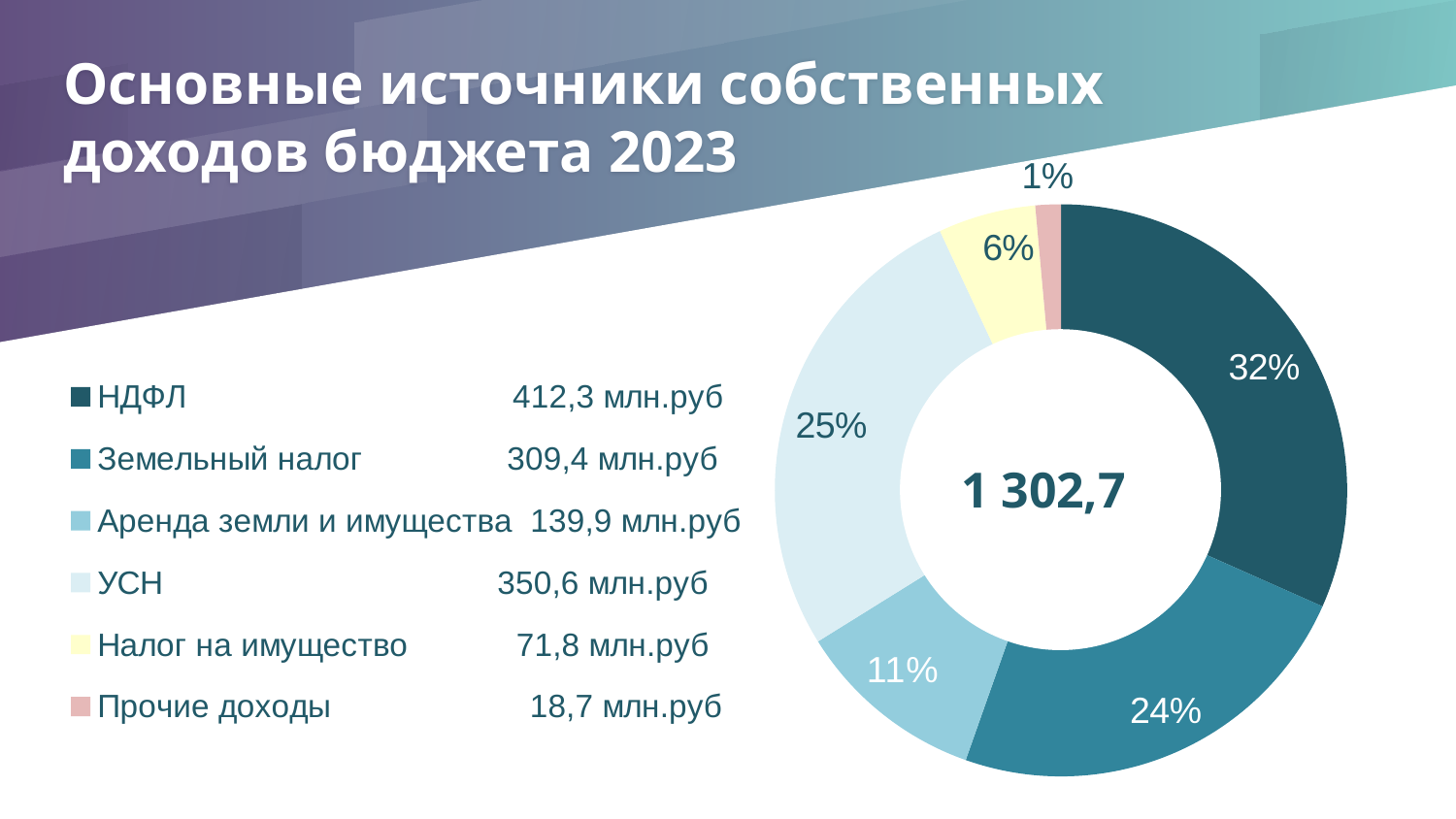
What type of chart is shown on the slide? Donut (pie) chart What share of the donut chart does НДФЛ account for? 32% What value in млн.руб is listed for Налог на имущество? 71,8 млн.руб Which income source has the largest share of the donut chart? НДФЛ What is the difference in percentage points between the НДФЛ share and the Земельный налог share? 8 percentage points Which income source has the smallest share of the donut chart? Прочие доходы What value in млн.руб is listed for Аренда земли и имущества? 139,9 млн.руб What share of the donut chart does УСН account for? 25% What total value is printed in the centre of the donut chart? 1 302,7 How many income sources are shown in the chart? 6 Which is larger in млн.руб: УСН or Земельный налог? УСН What share of the donut chart does Земельный налог account for? 24%